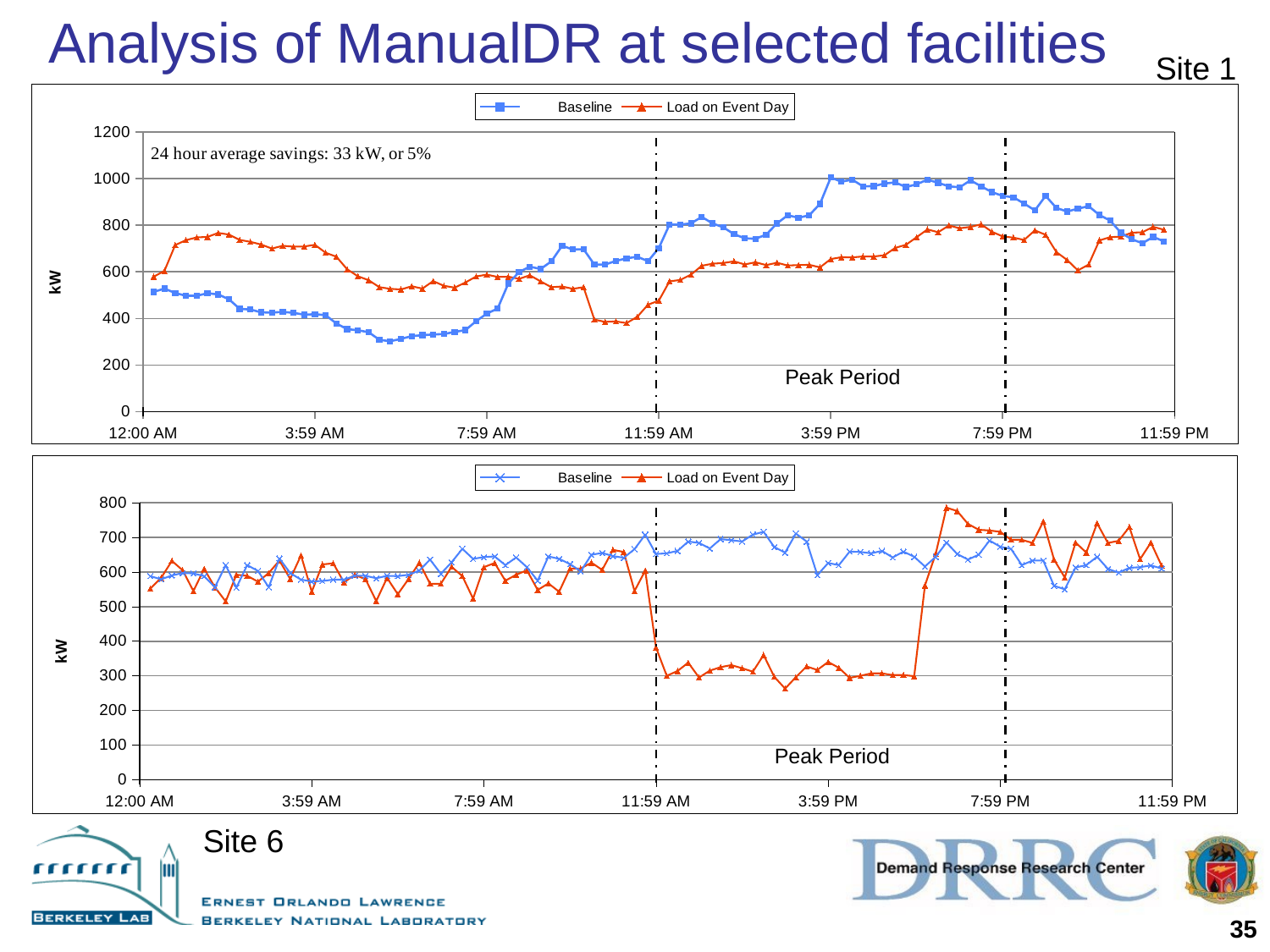
In the bottom chart (Site 6), which series is higher at 3:59 PM, Baseline or Load on Event Day? Baseline In the top chart (Site 1), is the Load on Event Day value at 11:59 AM greater or less than 600? less What are the two series named in the legend of the top chart (Site 1)? Baseline and Load on Event Day In the bottom chart (Site 6), is the Load on Event Day value at 3:59 PM greater or less than 400? less In the top chart (Site 1), is the Baseline value at 12:00 AM greater or less than 600? less How many series does the legend of the bottom chart (Site 6) list? 2 In the top chart (Site 1), which series is higher at 3:59 PM, Baseline or Load on Event Day? Baseline In the top chart (Site 1), does the Baseline series generally rise or fall between 7:59 AM and 3:59 PM? Rise What kind of chart is the top chart (Site 1)? Line chart According to the annotation on the top chart (Site 1), what is the 24 hour average savings? 33 kW, or 5%